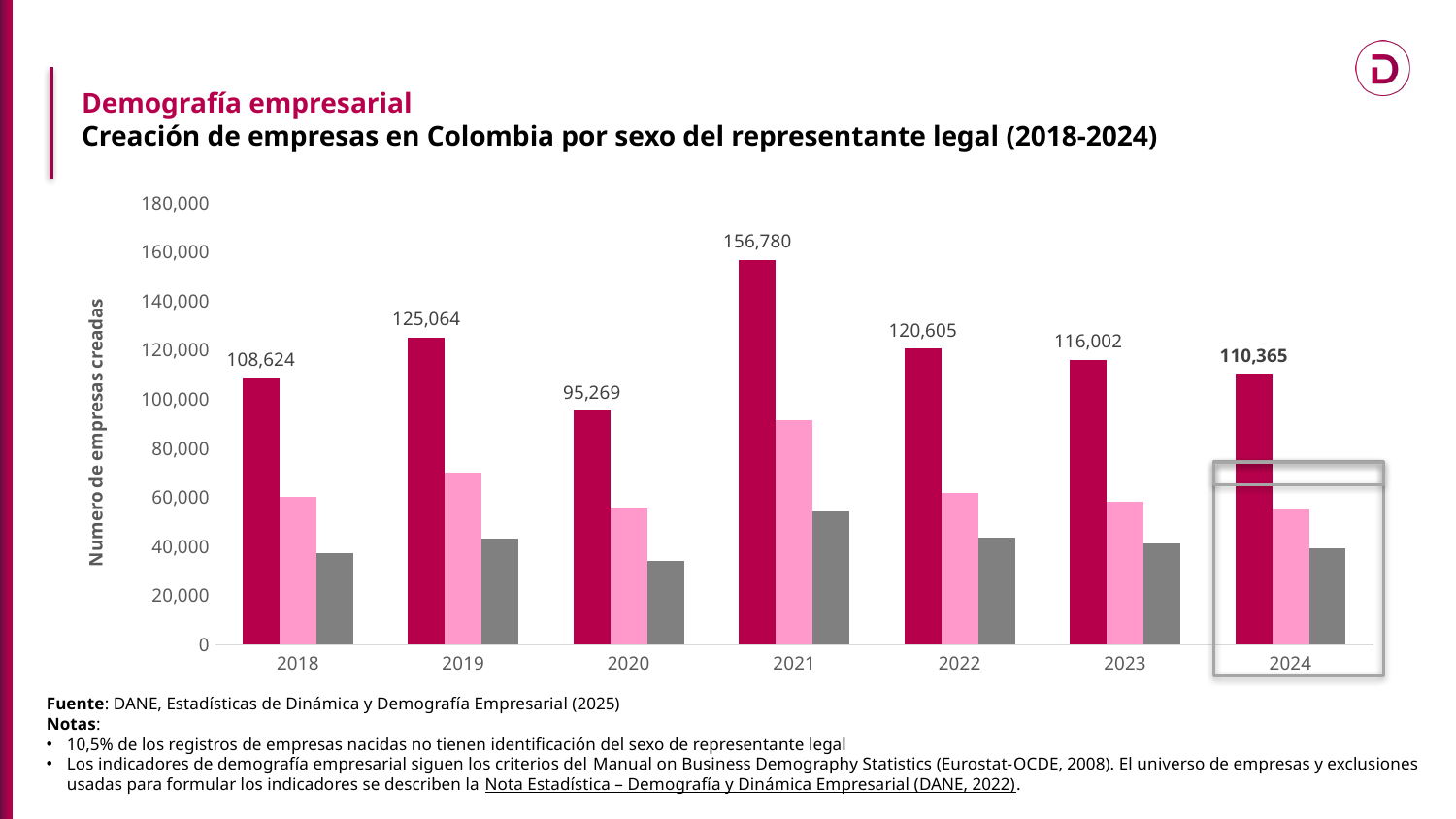
What is the difference between the labelled dark red bar values for 2021 and 2020? 61,511 Is the value of the gray bar for 2020 greater or less than 40,000? less What is the difference between the labelled dark red bar values for 2019 and 2018? 16,440 What is the value of the labelled dark red bar for 2021? 156,780 What kind of chart is shown on the slide? bar chart What is the value of the labelled dark red bar for 2024? 110,365 Is the value of the pink bar for 2021 greater or less than 80,000? greater In which year is the labelled dark red bar the lowest? 2020 How many years are shown on the x axis? 7 In which year is the labelled dark red bar the highest? 2021 What is the value of the labelled dark red bar for 2020? 95,269 Which year has the larger labelled dark red bar, 2022 or 2023? 2022